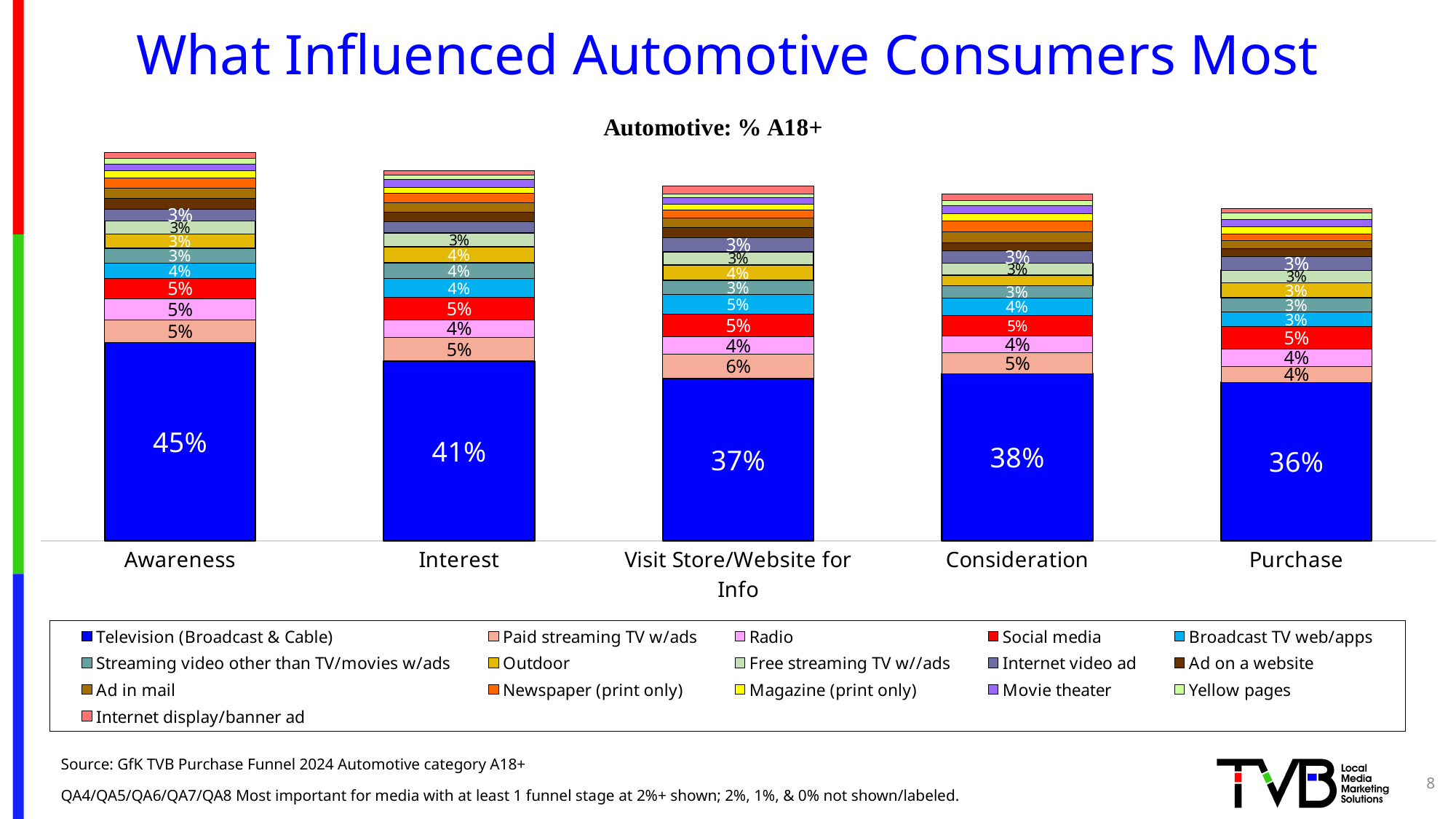
What is the title of the chart? Automotive: % A18+ What is the value for Television (Broadcast & Cable) in the Awareness stage? 45% What is the value for Television (Broadcast & Cable) in the Purchase stage? 36% Which has a larger Television (Broadcast & Cable) value, Interest or Consideration? Interest What kind of chart is shown on the slide? Stacked bar chart Which funnel stage has the lowest Television (Broadcast & Cable) value? Purchase What is the difference between the Television (Broadcast & Cable) values for Awareness and Purchase? 9 percentage points Which funnel stage has the highest Television (Broadcast & Cable) value? Awareness What is the value for Paid streaming TV w/ads in the Visit Store/Website for Info stage? 6% How many series does the legend list? 16 What is the value for Social media in the Consideration stage? 5% How many funnel stages are shown on the x axis? 5